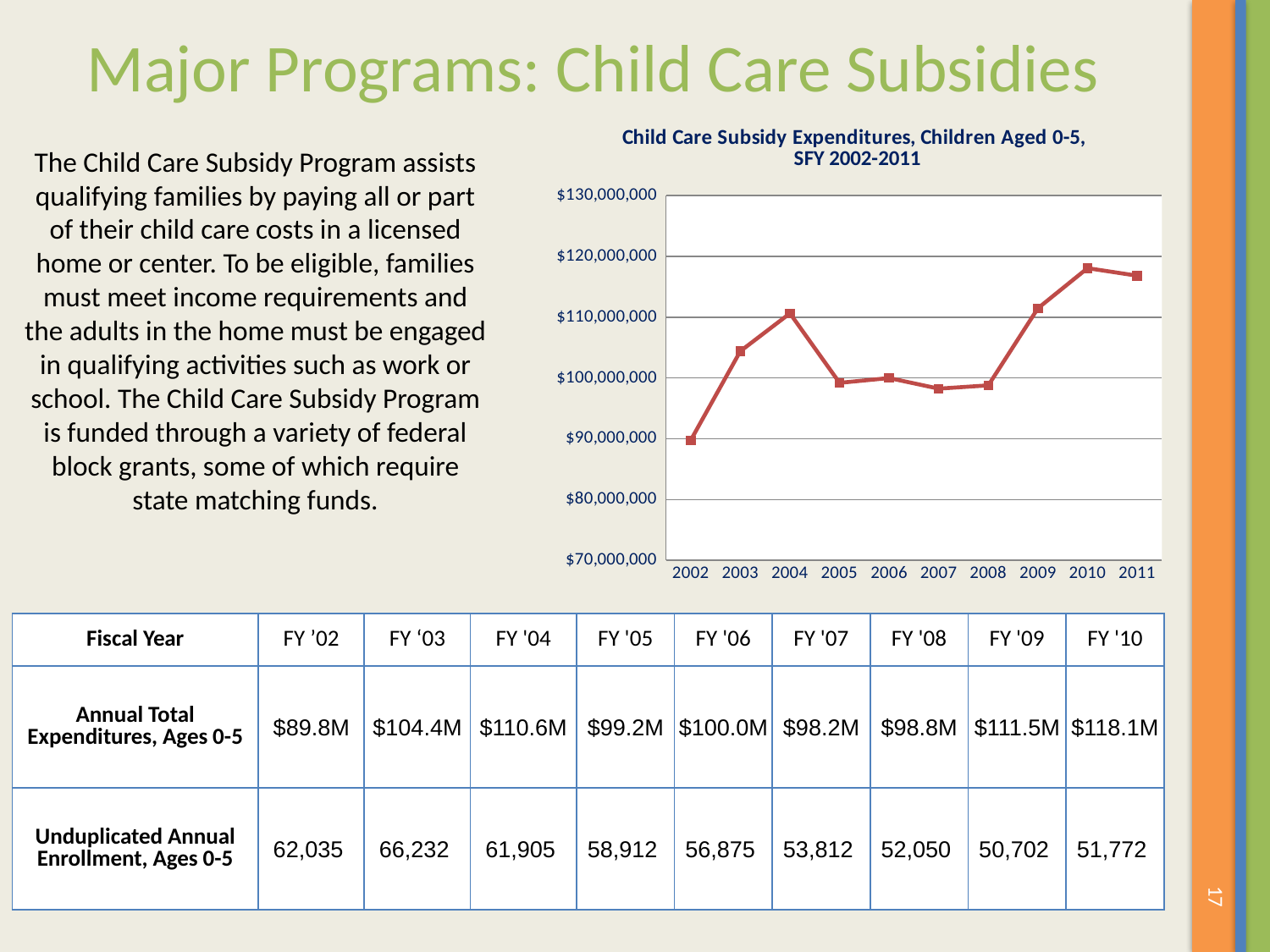
What type of chart is shown on the slide? line chart Do expenditures rise or fall from 2002 to 2004? rise Using the table values, what is the difference between annual total expenditures in FY '10 and FY '02? $28.3M According to the table, what were the annual total expenditures for ages 0-5 in FY '04? $110.6M What is the title of the chart on the slide? Child Care Subsidy Expenditures, Children Aged 0-5, SFY 2002-2011 Do expenditures rise or fall from 2004 to 2005? fall Is the expenditure value for 2011 greater or less than $110,000,000? greater Is the expenditure value for 2002 greater or less than $80,000,000? greater Is the expenditure value for 2007 greater or less than $100,000,000? less How many years are plotted on the x axis of the chart? 10 Which year has the higher expenditure, 2003 or 2005? 2003 Which year has the lowest child care subsidy expenditure in the chart? 2002